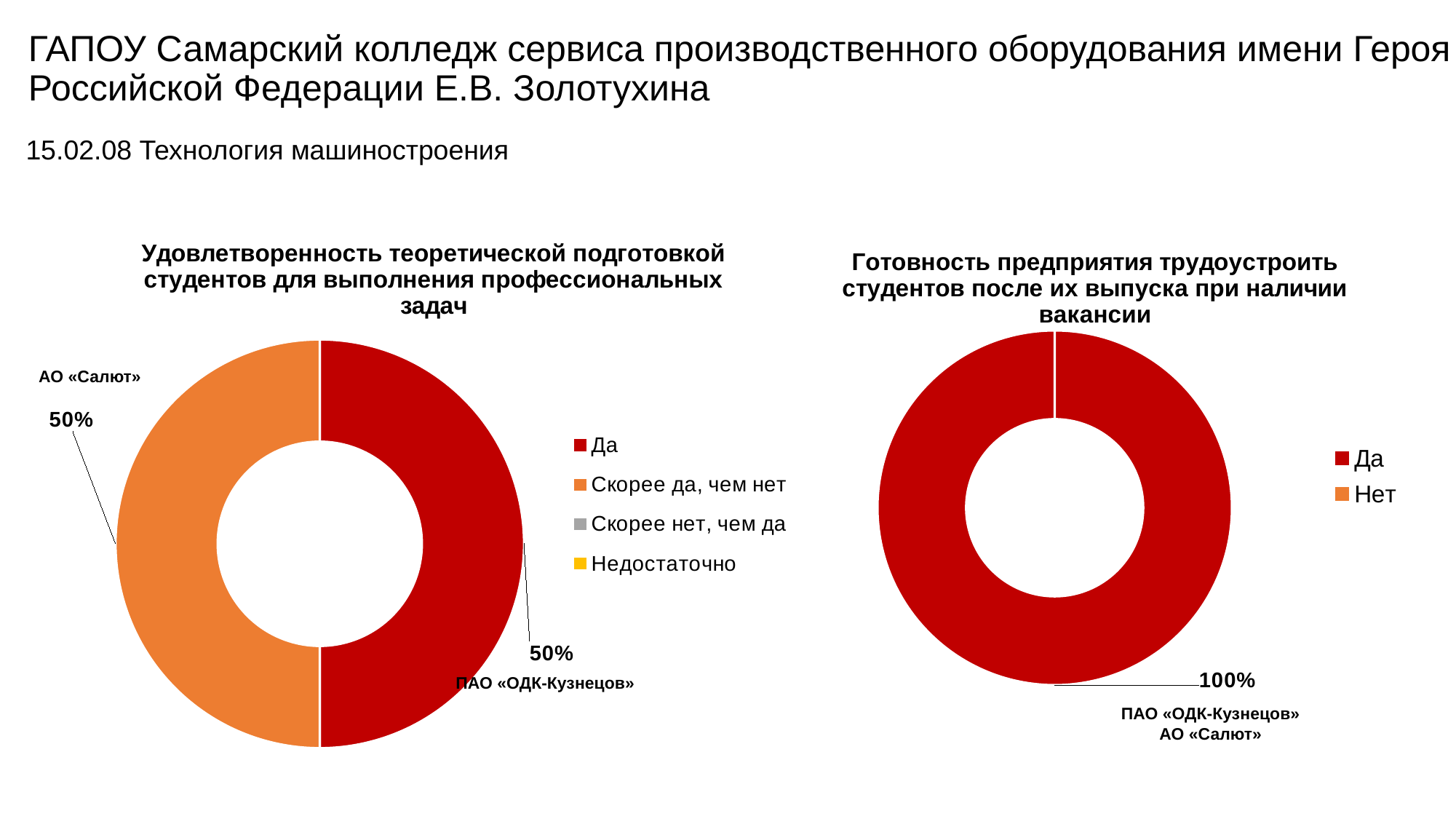
In the left chart (Удовлетворенность теоретической подготовкой студентов), how many slices are visible in the doughnut? 2 In the left chart (Удовлетворенность теоретической подготовкой студентов), which enterprise is labelled next to the 'Да' slice? ПАО «ОДК-Кузнецов» What kind of chart is the right chart (Готовность предприятия трудоустроить студентов)? Doughnut (pie) chart In the right chart (Готовность предприятия трудоустроить студентов), what share is labelled for the 'Да' slice? 100% How many entries does the legend of the right chart (Готовность предприятия трудоустроить студентов) list? 2 In the right chart (Готовность предприятия трудоустроить студентов), how many slices are visible in the doughnut? 1 In the left chart (Удовлетворенность теоретической подготовкой студентов), what is the difference between the 'Да' share and the 'Скорее да, чем нет' share? 0% How many entries does the legend of the left chart (Удовлетворенность теоретической подготовкой студентов) list? 4 In the left chart (Удовлетворенность теоретической подготовкой студентов), which enterprise is labelled next to the 'Скорее да, чем нет' slice? АО «Салют» What kind of chart is the left chart (Удовлетворенность теоретической подготовкой студентов)? Doughnut (pie) chart In the left chart (Удовлетворенность теоретической подготовкой студентов), what share is labelled for the 'Да' slice? 50% In the left chart (Удовлетворенность теоретической подготовкой студентов), what share is labelled for the 'Скорее да, чем нет' slice? 50%